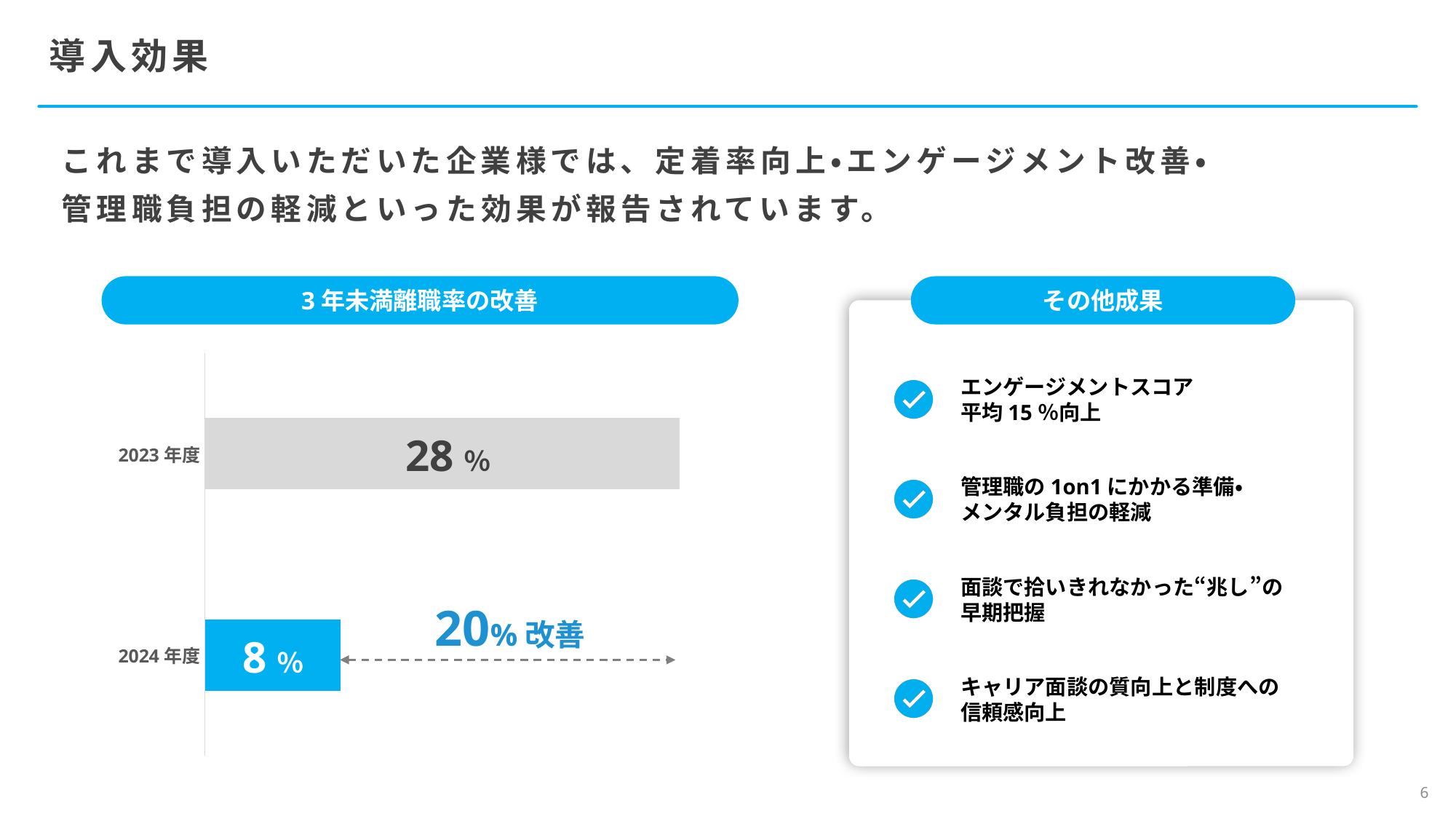
How many bars are shown in the 3 年未満離職率の改善 chart? 2 What colour is the 2024 年度 bar in the 3 年未満離職率の改善 chart? blue What is the value for 2023 年度 in the 3 年未満離職率の改善 chart? 28 % What kind of chart is used to show 3 年未満離職率の改善? bar chart Is the value for 2024 年度 larger or smaller than the value for 2023 年度 in the 3 年未満離職率の改善 chart? smaller What is the difference between the 2023 年度 and 2024 年度 values in the 3 年未満離職率の改善 chart? 20 % Does the value rise or fall from 2023 年度 to 2024 年度 in the 3 年未満離職率の改善 chart? fall What improvement is annotated between the two bars in the 3 年未満離職率の改善 chart? 20% 改善 Which year has the lower value in the 3 年未満離職率の改善 chart? 2024 年度 What is the value for 2024 年度 in the 3 年未満離職率の改善 chart? 8 % Which year has the higher value in the 3 年未満離職率の改善 chart? 2023 年度